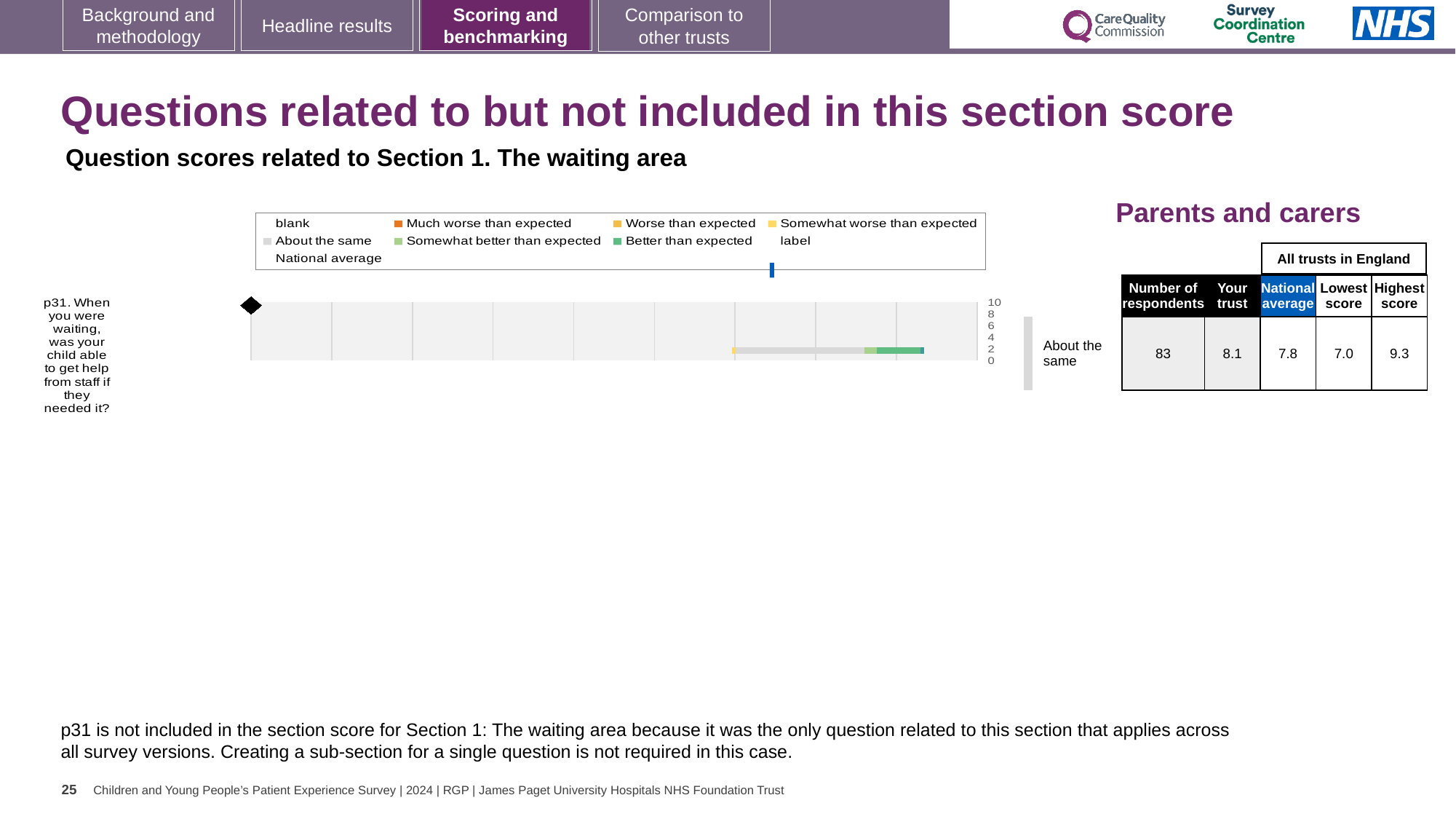
What is the 'Your trust' score for p31 in the table beside the chart? 8.1 What is the lowest score across all trusts in England for p31? 7.0 What is the highest score across all trusts in England for p31? 9.3 What is the difference between the highest score and the lowest score for p31? 2.3 Is the 'Your trust' score for p31 higher or lower than the national average? higher What is the national average score for p31 in the table beside the chart? 7.8 What colour represents 'Much worse than expected' in the chart legend? orange How many respondents answered p31? 83 How many questions are plotted in the chart? 1 Which question is plotted in the chart? p31. When you were waiting, was your child able to get help from staff if they needed it? What benchmark category is shown next to the chart for p31? About the same What kind of chart is used to show the p31 question score? bar chart